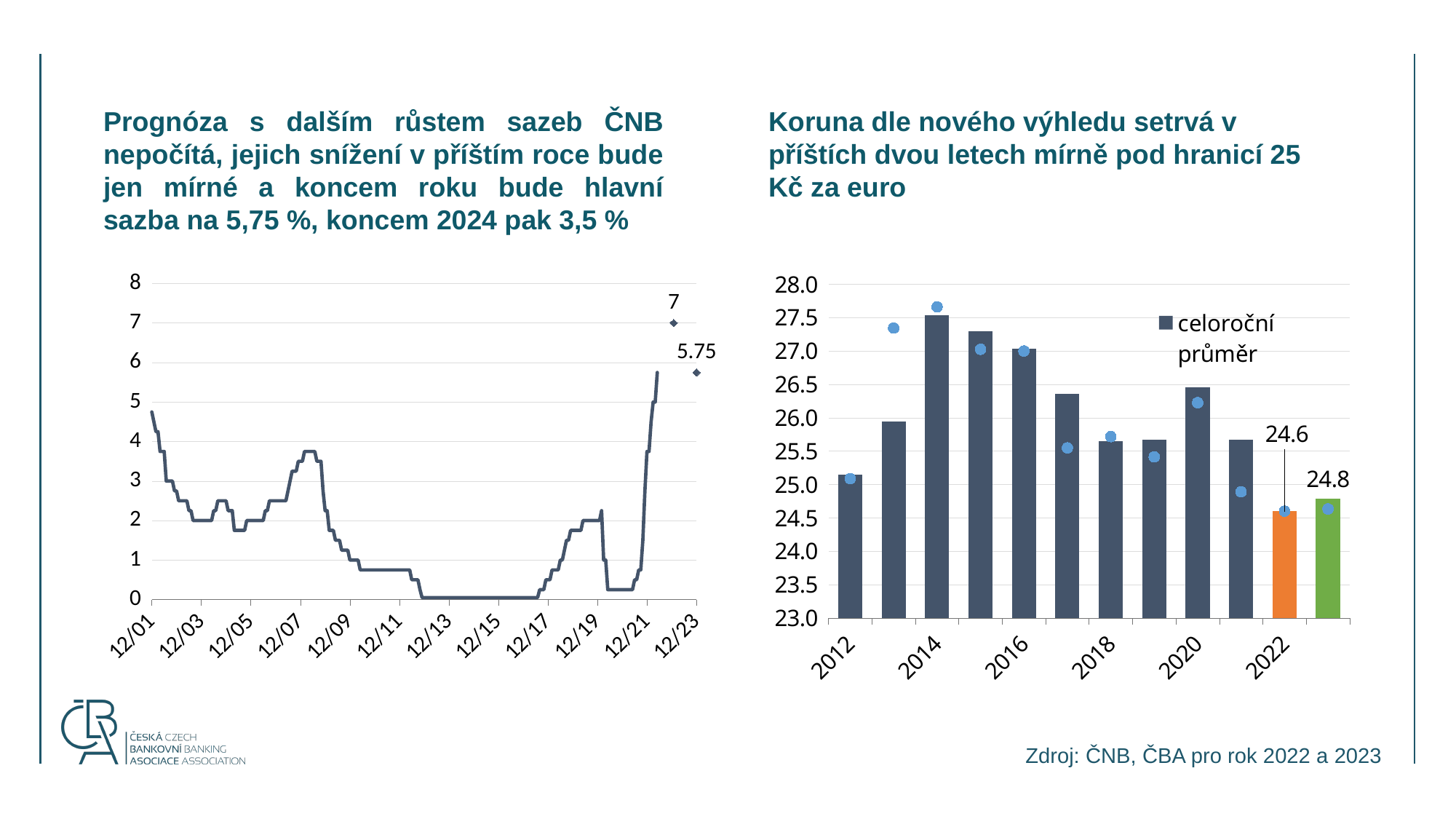
On the left chart, is the value at 12/15 greater or less than 1? less On the right chart, which year has the lowest bar? 2022 What kind of chart is the left chart (Prognóza s dalším růstem sazeb ČNB nepočítá)? line chart On the left chart, is the value at 12/01 greater or less than 4? greater On the left chart, what is the higher of the two labelled values near the right end of the series? 7 On the right chart, what entry does the legend show? celoroční průměr What kind of chart is the right chart (Koruna dle nového výhledu)? combination bar and line chart (bars with point markers) On the right chart, what is the value for 2023? 24.8 On the right chart, what is the value for 2022? 24.6 On the right chart, which year has the highest bar? 2014 On the left chart, what value is labelled at the 12/23 end of the series? 5.75 On the right chart, what is the difference between the values for 2023 and 2022? 0.2